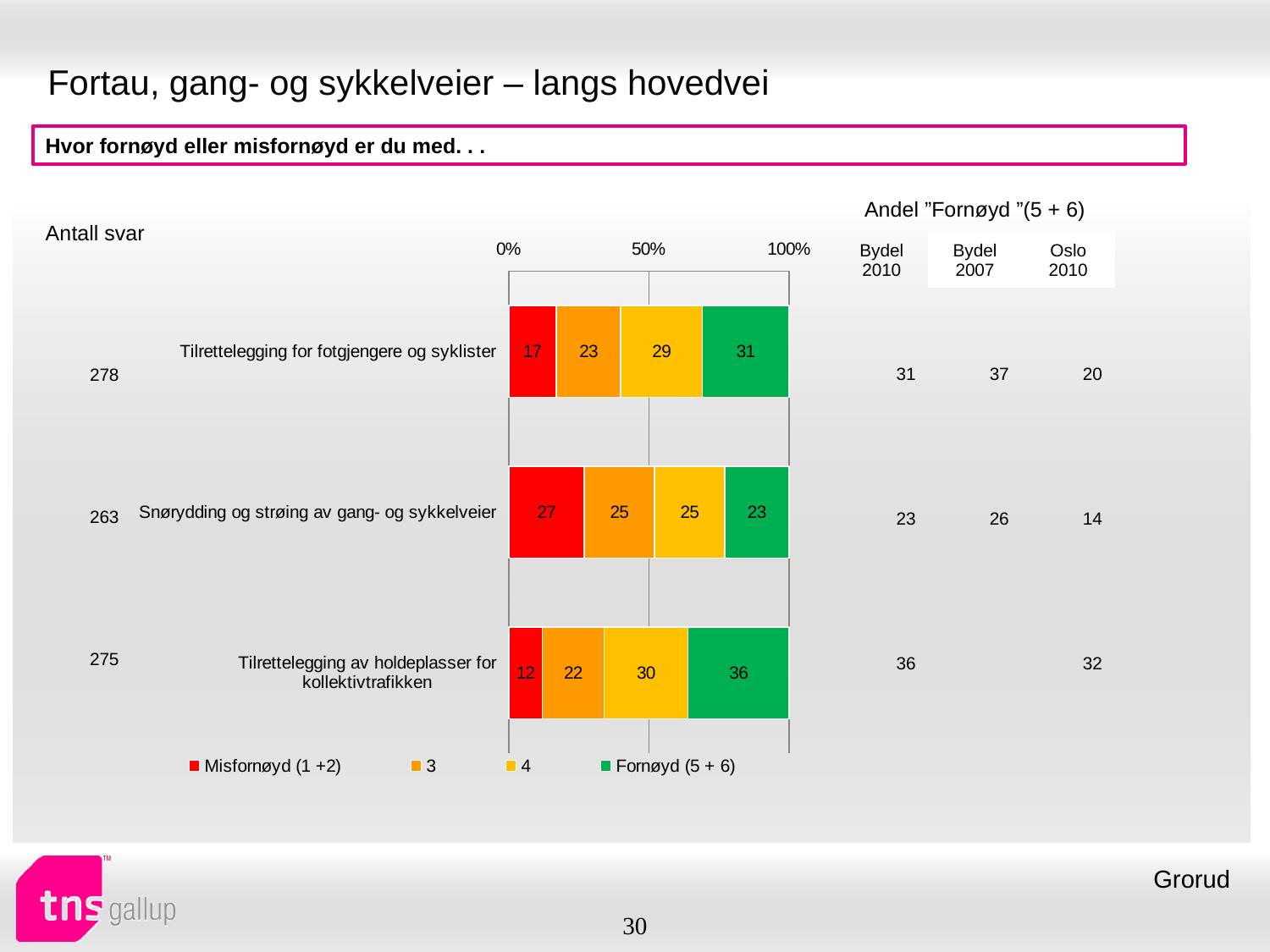
What kind of chart is shown on the slide? Stacked bar chart What is the difference between the Fornøyd (5 + 6) values for 'Tilrettelegging av holdeplasser for kollektivtrafikken' and 'Snørydding og strøing av gang- og sykkelveier'? 13 What is the total of the stacked bar for 'Snørydding og strøing av gang- og sykkelveier'? 100 Which category has the highest Fornøyd (5 + 6) value? Tilrettelegging av holdeplasser for kollektivtrafikken Which category has the lowest Misfornøyd (1 +2) value? Tilrettelegging av holdeplasser for kollektivtrafikken What is the value of the Misfornøyd (1 +2) segment for 'Snørydding og strøing av gang- og sykkelveier'? 27 What is the value of the '4' segment for 'Tilrettelegging av holdeplasser for kollektivtrafikken'? 30 Which colour represents the Fornøyd (5 + 6) series in the legend? Green What is the value of the Fornøyd (5 + 6) segment for 'Tilrettelegging for fotgjengere og syklister'? 31 How many categories are shown in the chart? 3 How many series does the legend list? 4 Which is larger: the Misfornøyd (1 +2) value for 'Snørydding og strøing av gang- og sykkelveier' or for 'Tilrettelegging for fotgjengere og syklister'? Snørydding og strøing av gang- og sykkelveier